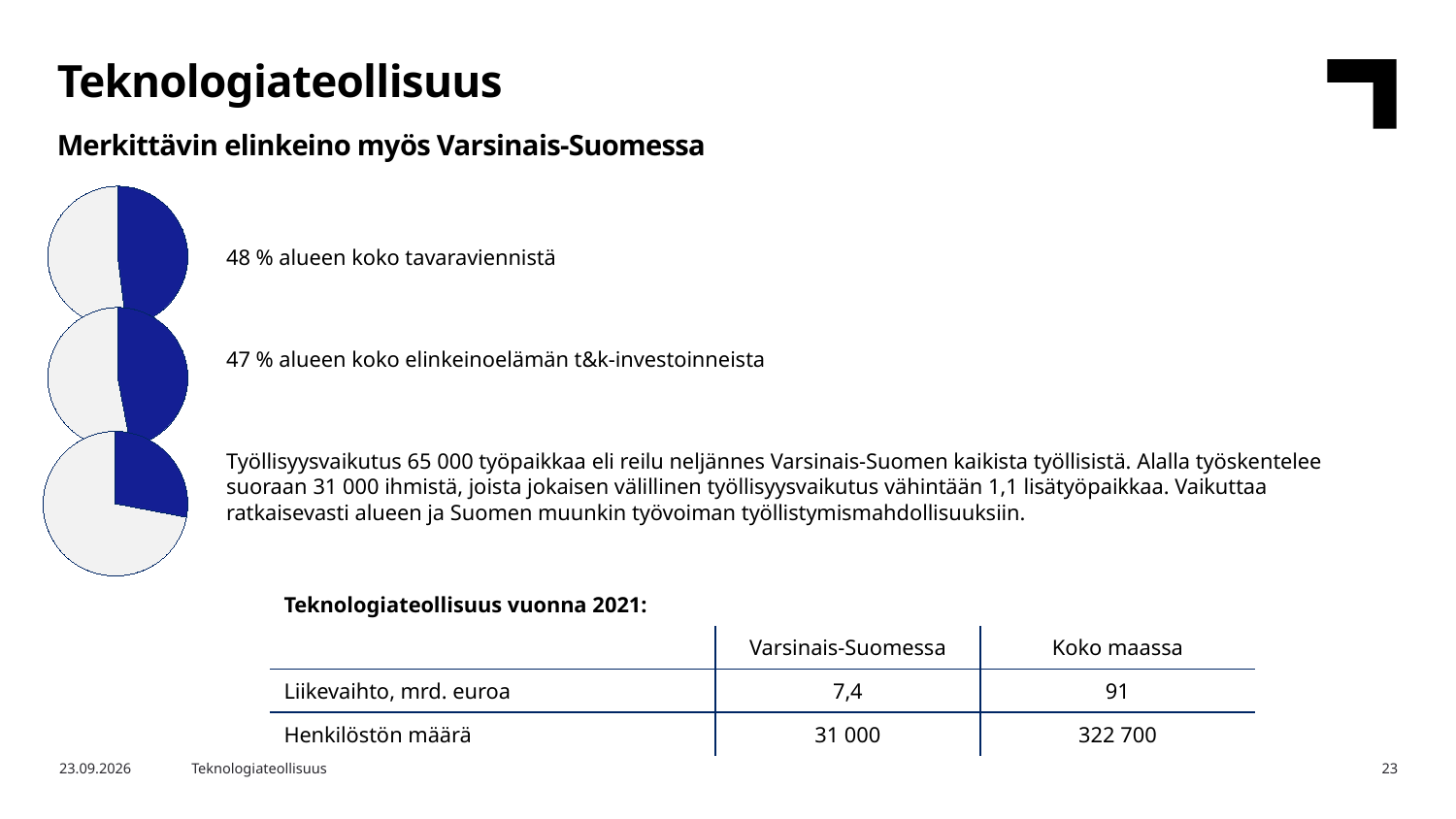
What colour is the highlighted slice in the pie charts? Blue What kind of charts are shown on the left side of the slide? Pie charts Is the highlighted slice of the bottom pie chart greater or less than half of the pie? less What share of the region's total goods exports does the top pie chart represent, according to the text beside it? 48 % How many slices does each pie chart have? 2 How many pie charts are on the slide? 3 Which pie chart has the smallest highlighted slice: the top, middle or bottom one? Bottom Is the highlighted slice in the top pie chart larger or smaller than the highlighted slice in the bottom pie chart? Larger What share of the region's business R&D investments does the middle pie chart represent, according to the text beside it? 47 %